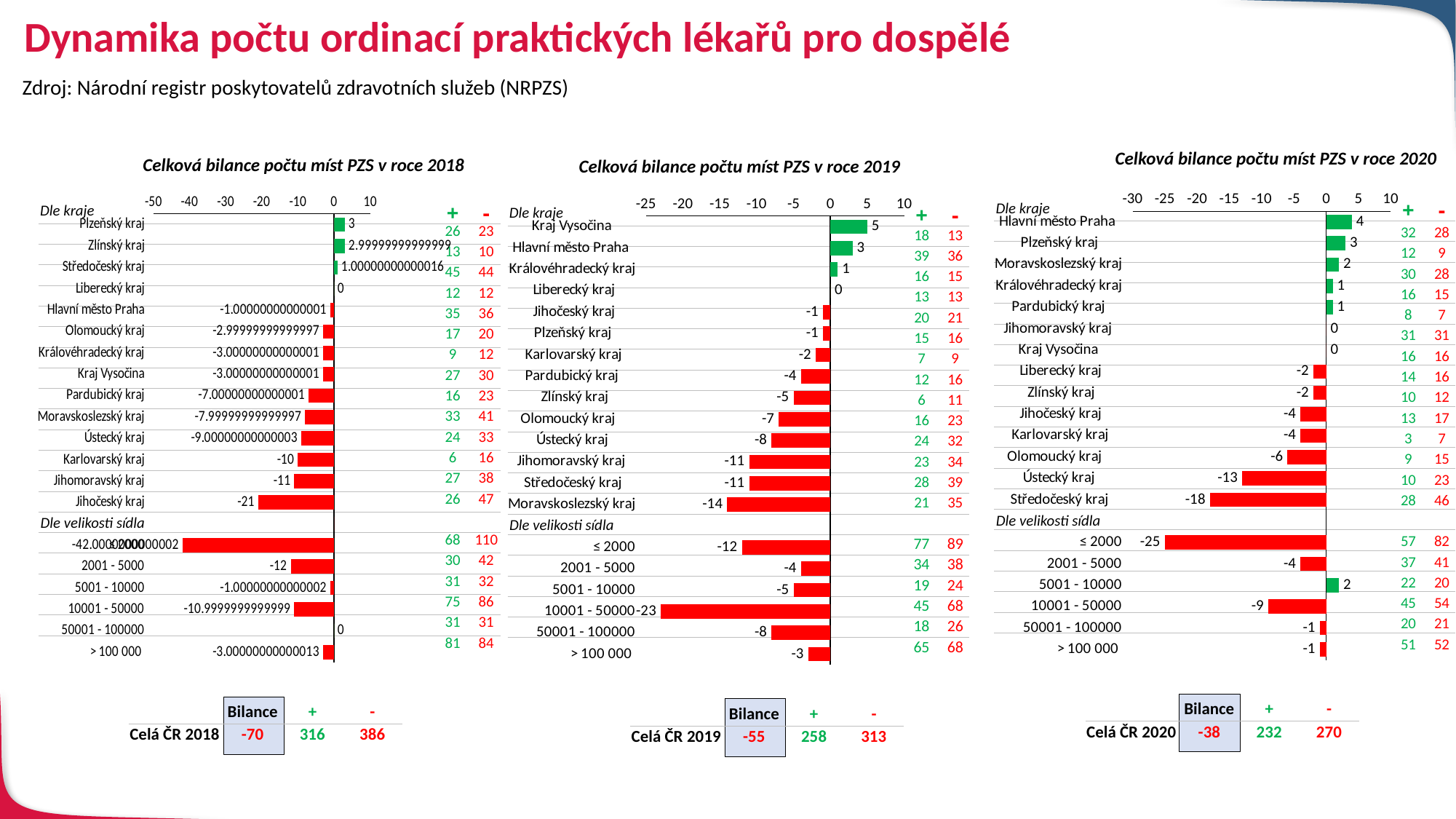
In the chart 'Celková bilance počtu míst PZS v roce 2019', what is the value for the '10001 - 50000' category? -23 What is the Bilance value shown for Celá ČR 2020? -38 In the chart 'Celková bilance počtu míst PZS v roce 2020', which settlement-size category has the lowest value? ≤ 2000 In the chart 'Celková bilance počtu míst PZS v roce 2019', which region has the highest value? Kraj Vysočina In the chart 'Celková bilance počtu míst PZS v roce 2019', what is the difference between the values for Moravskoslezský kraj and Kraj Vysočina? 19 In the chart 'Celková bilance počtu míst PZS v roce 2018', is the value for the '≤ 2000' category greater or less than -40? less In the chart 'Celková bilance počtu míst PZS v roce 2020', which is larger, the value for Ústecký kraj or the value for Olomoucký kraj? Olomoucký kraj In the chart 'Celková bilance počtu míst PZS v roce 2019', how many settlement-size categories (Dle velikosti sídla) are plotted? 6 In the chart 'Celková bilance počtu míst PZS v roce 2018', what is the value for Jihočeský kraj? -21 What type of chart is 'Celková bilance počtu míst PZS v roce 2020'? bar chart In the chart 'Celková bilance počtu míst PZS v roce 2019', what is the value for Moravskoslezský kraj? -14 In the chart 'Celková bilance počtu míst PZS v roce 2020', what is the value for Středočeský kraj? -18